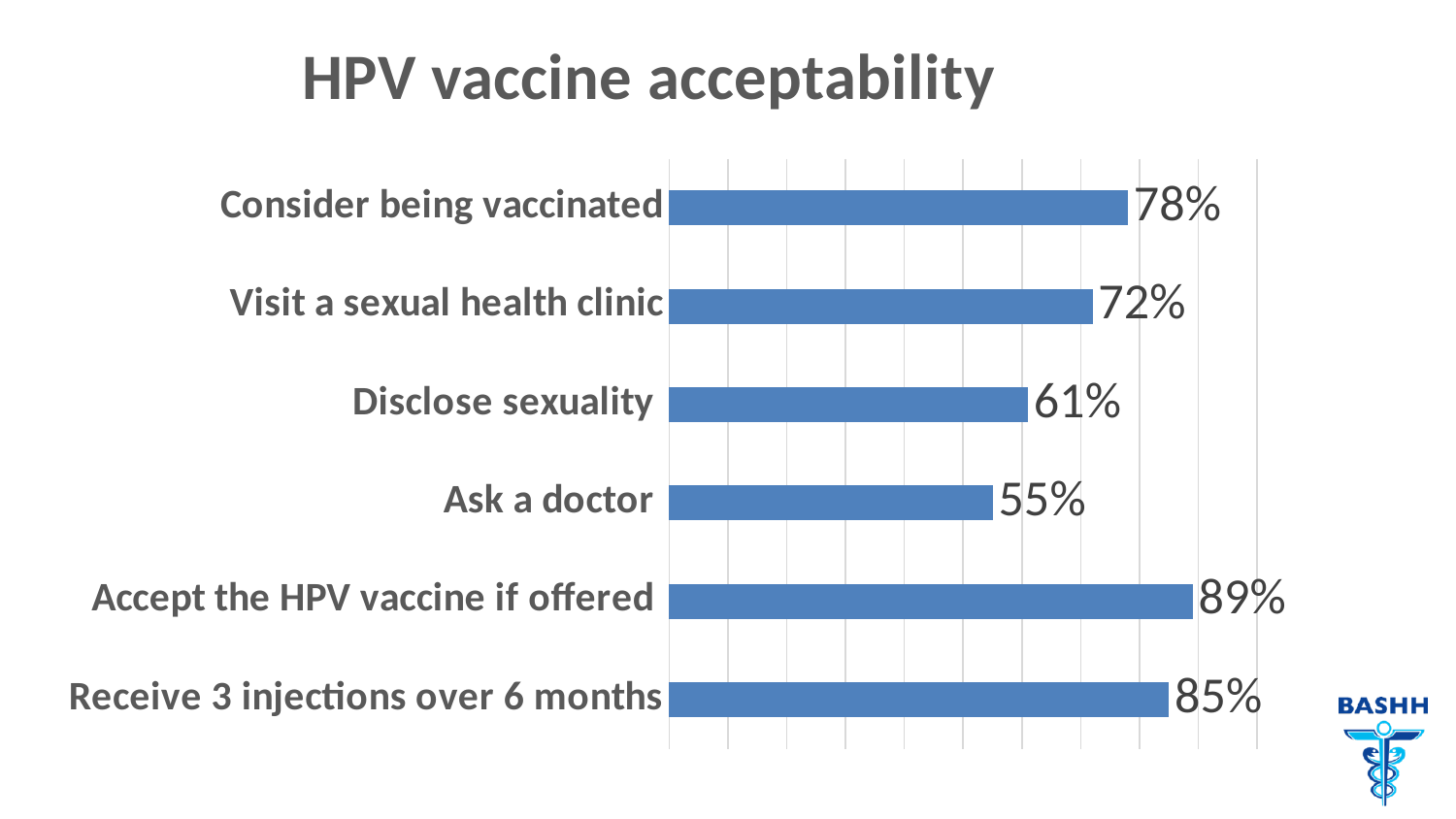
What percentage would consider being vaccinated? 78% What percentage would ask a doctor? 55% What is the difference between 'Accept the HPV vaccine if offered' and 'Ask a doctor'? 34% Which category has the highest value? Accept the HPV vaccine if offered What is the difference between 'Consider being vaccinated' and 'Visit a sexual health clinic'? 6% What is the value for 'Receive 3 injections over 6 months'? 85% Which is larger, 'Disclose sexuality' or 'Visit a sexual health clinic'? Visit a sexual health clinic What is the value for 'Accept the HPV vaccine if offered'? 89% What kind of chart is shown on the slide? Bar chart Which category has the lowest value? Ask a doctor How many categories are shown in the chart? 6 What is the title of the chart? HPV vaccine acceptability